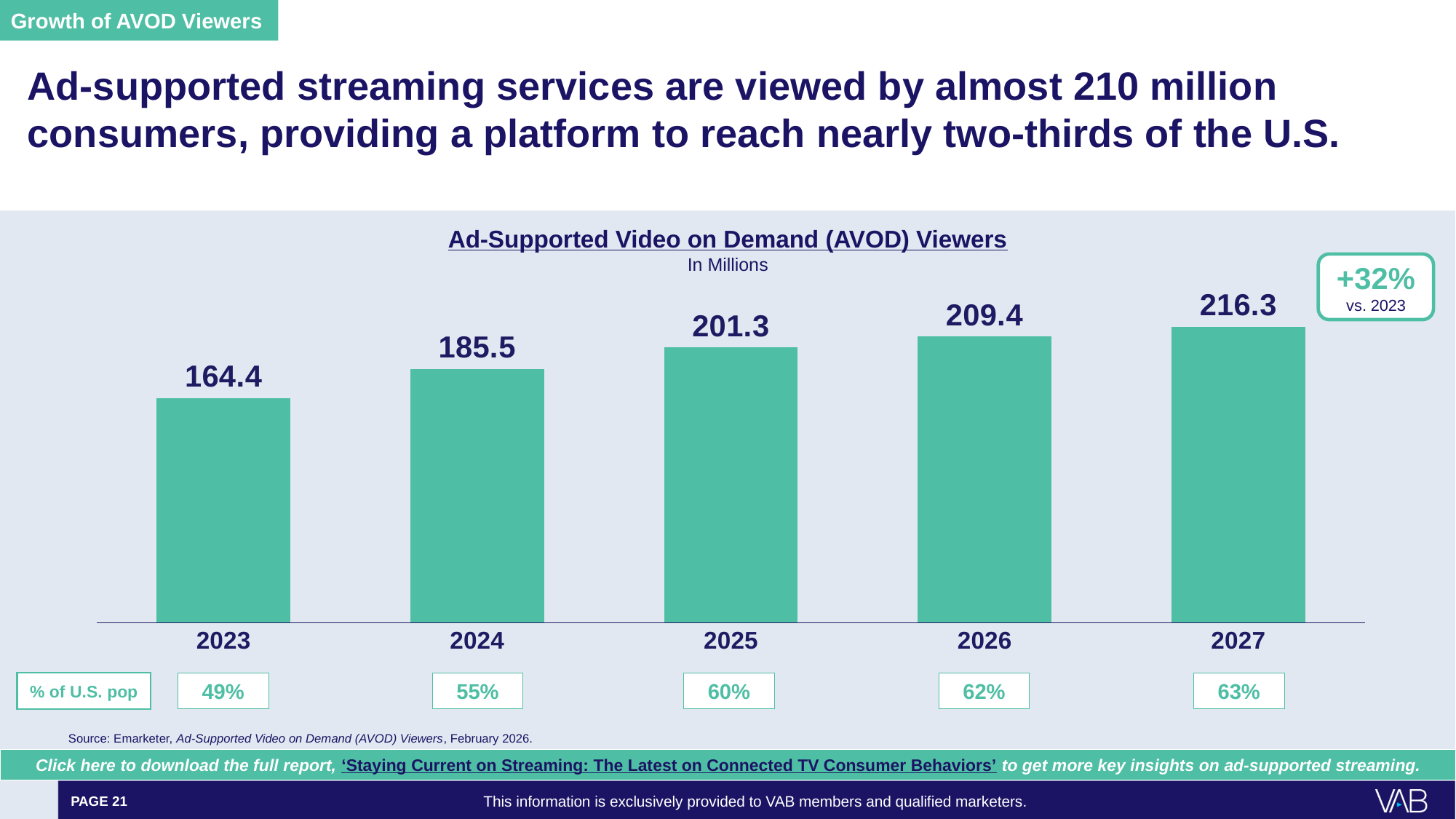
What kind of chart is used to show AVOD viewers? Bar chart What is the value for 2023 in the AVOD Viewers chart? 164.4 Which year has the lowest number of AVOD viewers? 2023 How many years are shown in the AVOD Viewers chart? 5 Which year has more AVOD viewers, 2024 or 2026? 2026 What is the value for 2027 in the AVOD Viewers chart? 216.3 What is the value for 2025 in the AVOD Viewers chart? 201.3 What is the difference in AVOD viewers between 2026 and 2025? 8.1 Which year has the highest number of AVOD viewers? 2027 What percentage of the U.S. population do AVOD viewers represent in 2025? 60% What is the difference in AVOD viewers between 2027 and 2023? 51.9 Do AVOD viewer numbers rise or fall from 2023 to 2027? Rise